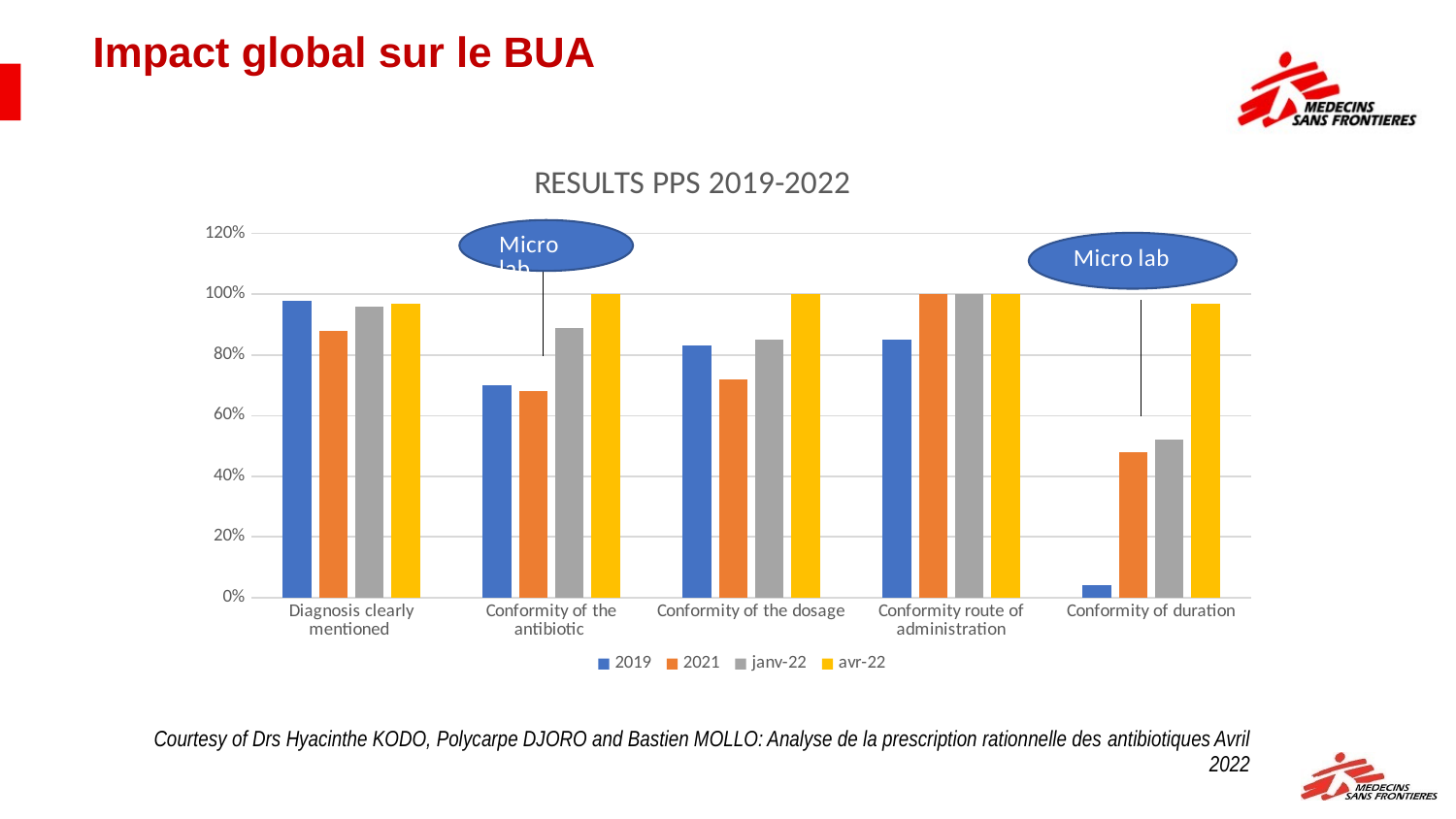
Is the 2021 value for Conformity of duration greater or less than 40%? greater Is the 2019 value for Diagnosis clearly mentioned greater or less than 80%? greater What is the 2021 value for Conformity route of administration? 100% What is the title of the chart? RESULTS PPS 2019-2022 What is the avr-22 value for Conformity route of administration? 100% How many series does the legend list? 4 Which series has the lowest value for Conformity of duration? 2019 Is the 2019 value for Conformity of duration greater or less than 20%? less How many categories are shown on the x axis? 5 For Diagnosis clearly mentioned, which is larger: the 2019 value or the 2021 value? 2019 What type of chart is shown on the slide? bar chart What is the avr-22 value for Conformity of the dosage? 100%